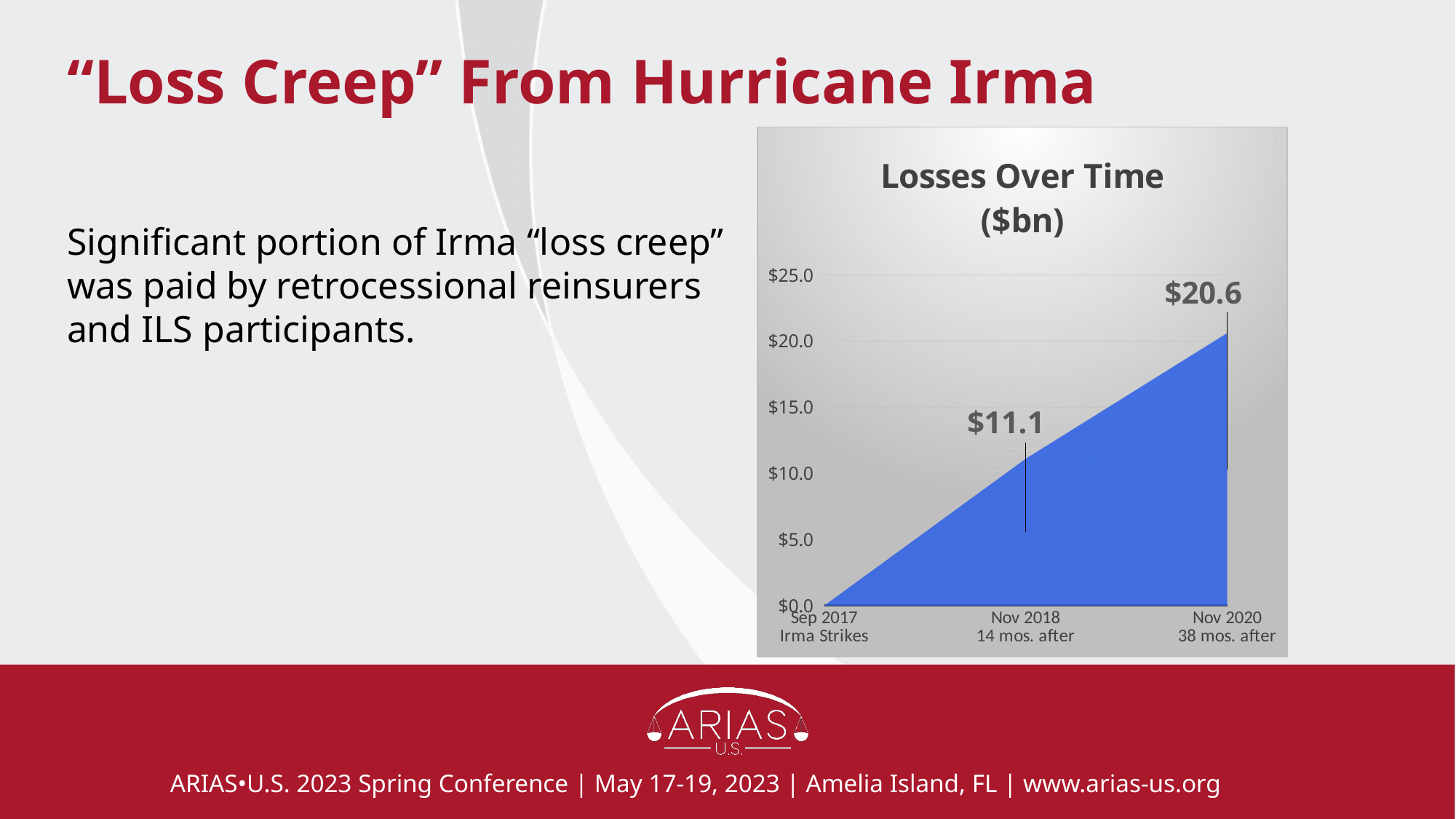
What is the value for Nov 2020 (38 mos. after) in the Losses Over Time chart? $20.6 How many time points are plotted on the Losses Over Time chart? 3 Which point on the Losses Over Time chart has the lowest value? Sep 2017 (Irma Strikes) Which is larger in the Losses Over Time chart, the value for Nov 2018 or the value for Nov 2020? Nov 2020 What is the value for Nov 2018 (14 mos. after) in the Losses Over Time chart? $11.1 Is the value for Nov 2020 in the Losses Over Time chart greater or less than $25.0? less Which point on the Losses Over Time chart has the highest value? Nov 2020 (38 mos. after) Do the values in the Losses Over Time chart rise or fall from Sep 2017 to Nov 2020? Rise What is the difference between the Nov 2020 value and the Nov 2018 value in the Losses Over Time chart? $9.5 What unit is given in the title of the Losses Over Time chart? $bn Is the value for Nov 2018 in the Losses Over Time chart greater or less than $10.0? greater What kind of chart is the Losses Over Time chart? Area chart